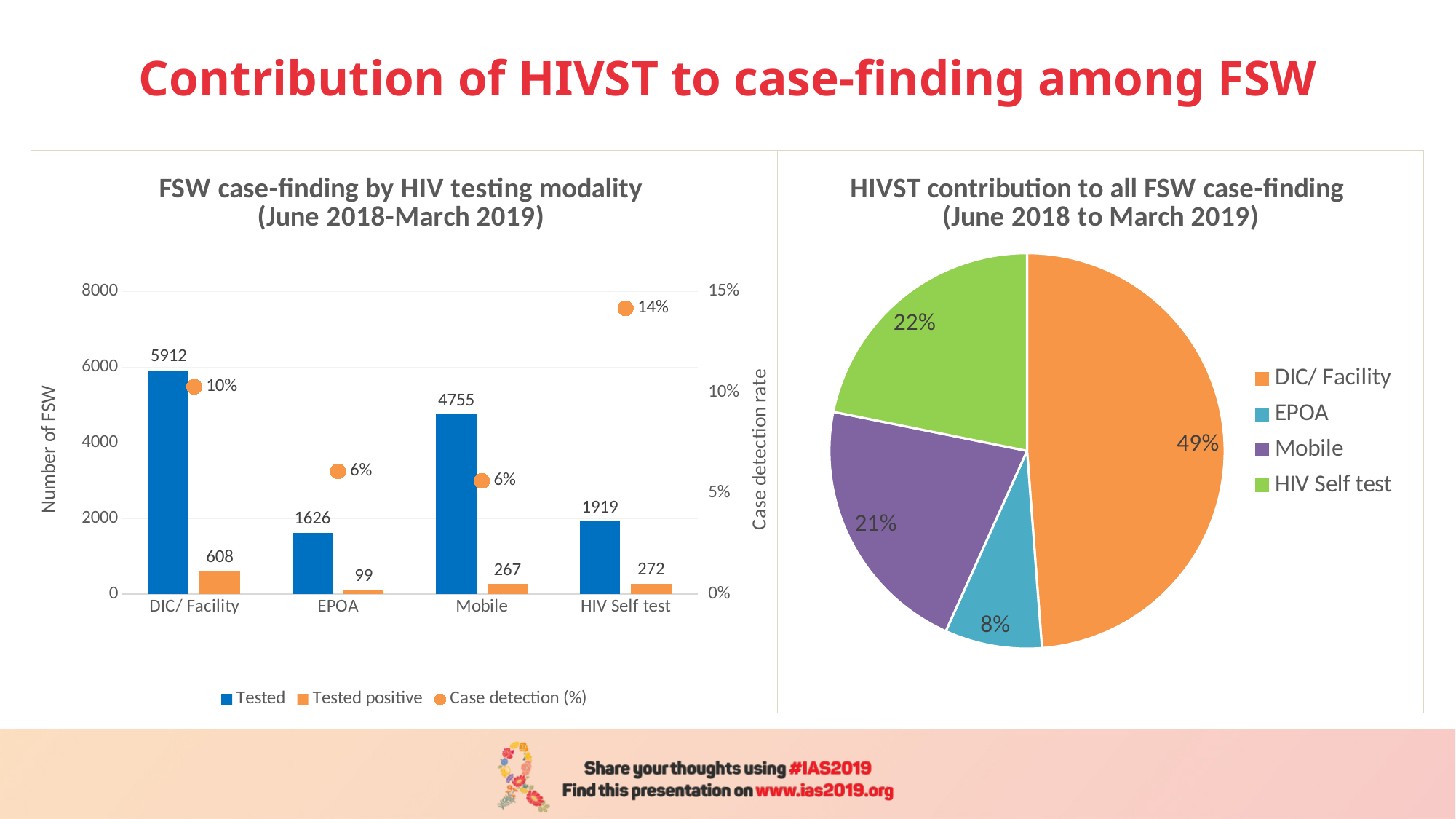
In the 'HIVST contribution to all FSW case-finding' chart, what share does HIV Self test account for? 22% In the 'HIVST contribution to all FSW case-finding' chart, which category has the smallest slice? EPOA In the 'FSW case-finding by HIV testing modality' chart, which modality has the highest number tested? DIC/ Facility In the 'FSW case-finding by HIV testing modality' chart, what is the case detection rate for HIV Self test? 14% In the 'FSW case-finding by HIV testing modality' chart, how many series does the legend list? 3 What kind of chart is the 'HIVST contribution to all FSW case-finding' chart? Pie chart In the 'FSW case-finding by HIV testing modality' chart, which is larger: the number tested positive at Mobile or at HIV Self test? HIV Self test In the 'FSW case-finding by HIV testing modality' chart, which modality has the lowest number tested positive? EPOA In the 'FSW case-finding by HIV testing modality' chart, how many FSW were tested at DIC/ Facility? 5912 In the 'FSW case-finding by HIV testing modality' chart, how many testing modalities are shown on the x axis? 4 In the 'FSW case-finding by HIV testing modality' chart, how many FSW tested positive via HIV Self test? 272 In the 'FSW case-finding by HIV testing modality' chart, what is the difference between the number tested at DIC/ Facility and at Mobile? 1157